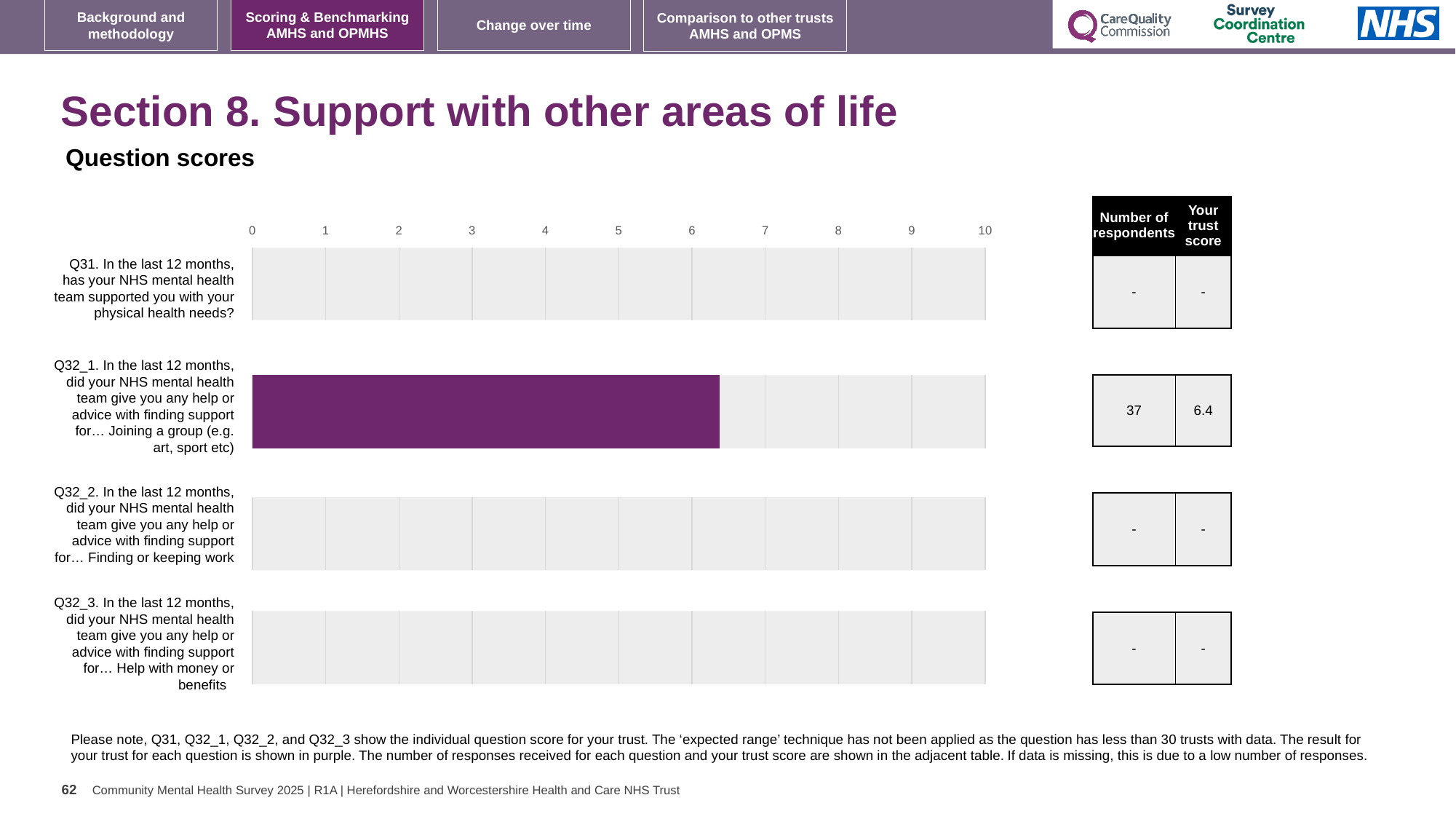
How many question categories are listed on the chart's vertical axis? 4 What colour is the bar for Q32_1? Purple What kind of chart is shown on the slide? Bar chart Is the value for Q32_1 greater or less than 7? less What is the maximum value shown on the chart's horizontal axis? 10 What trust score is shown in the table for Q31? - Which question has a bar plotted on the chart? Q32_1 How many of the four questions have no bar plotted (missing data)? 3 What is the number of respondents shown for Q32_3? - Is the value for Q32_1 greater or less than 5? greater How many respondents answered Q32_1 according to the table next to the chart? 37 What is the trust score for Q32_1 (help or advice with finding support for joining a group)? 6.4